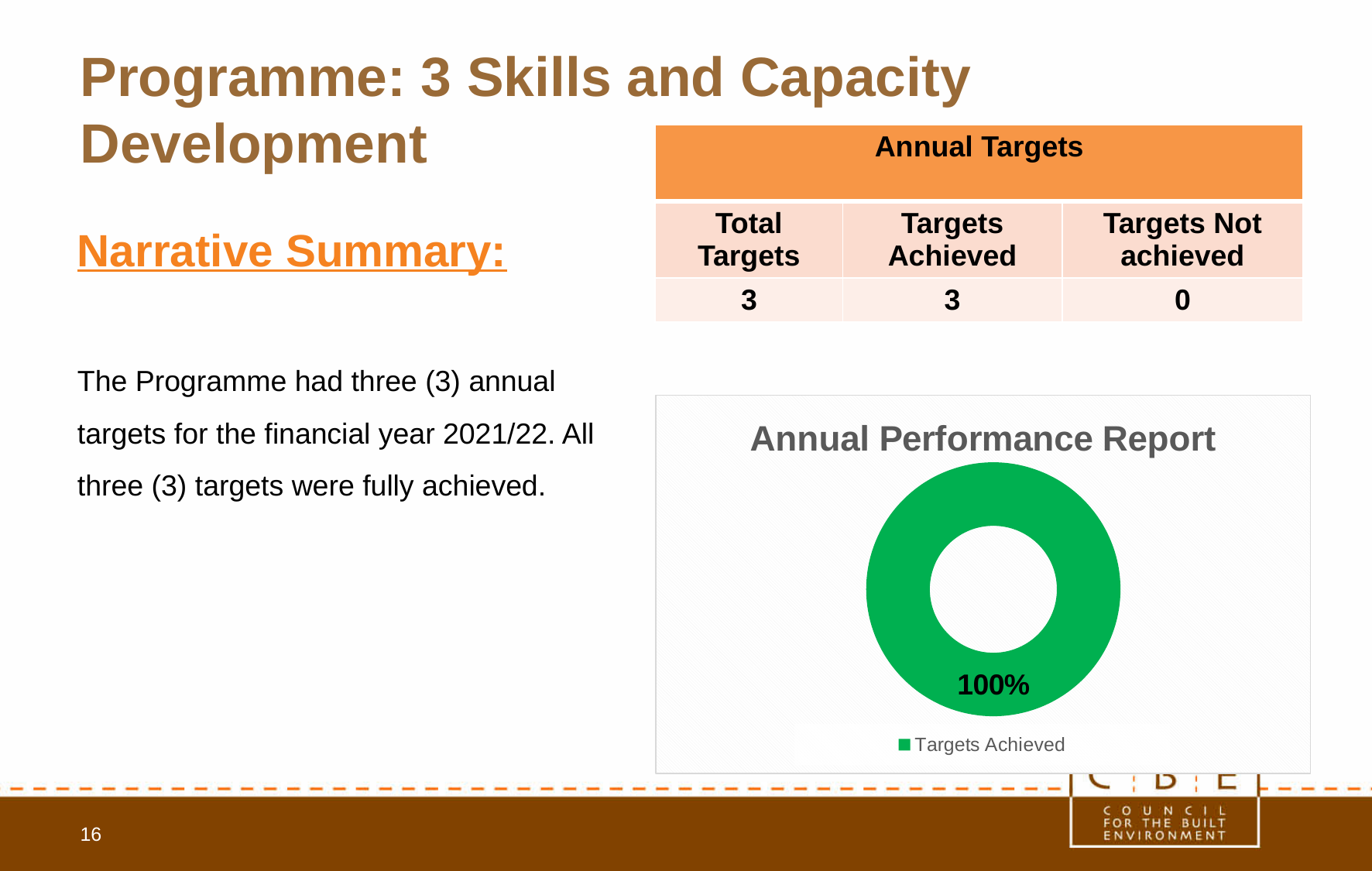
What share of the Annual Performance Report doughnut does Targets Achieved take up? 100% What kind of chart is the Annual Performance Report? doughnut chart How many entries does the legend of the Annual Performance Report chart list? 1 How many slices are plotted in the Annual Performance Report chart? 1 What is the title of the chart on the slide? Annual Performance Report What value is shown for Targets Achieved in the Annual Performance Report chart? 100% What is the legend entry shown below the Annual Performance Report chart? Targets Achieved